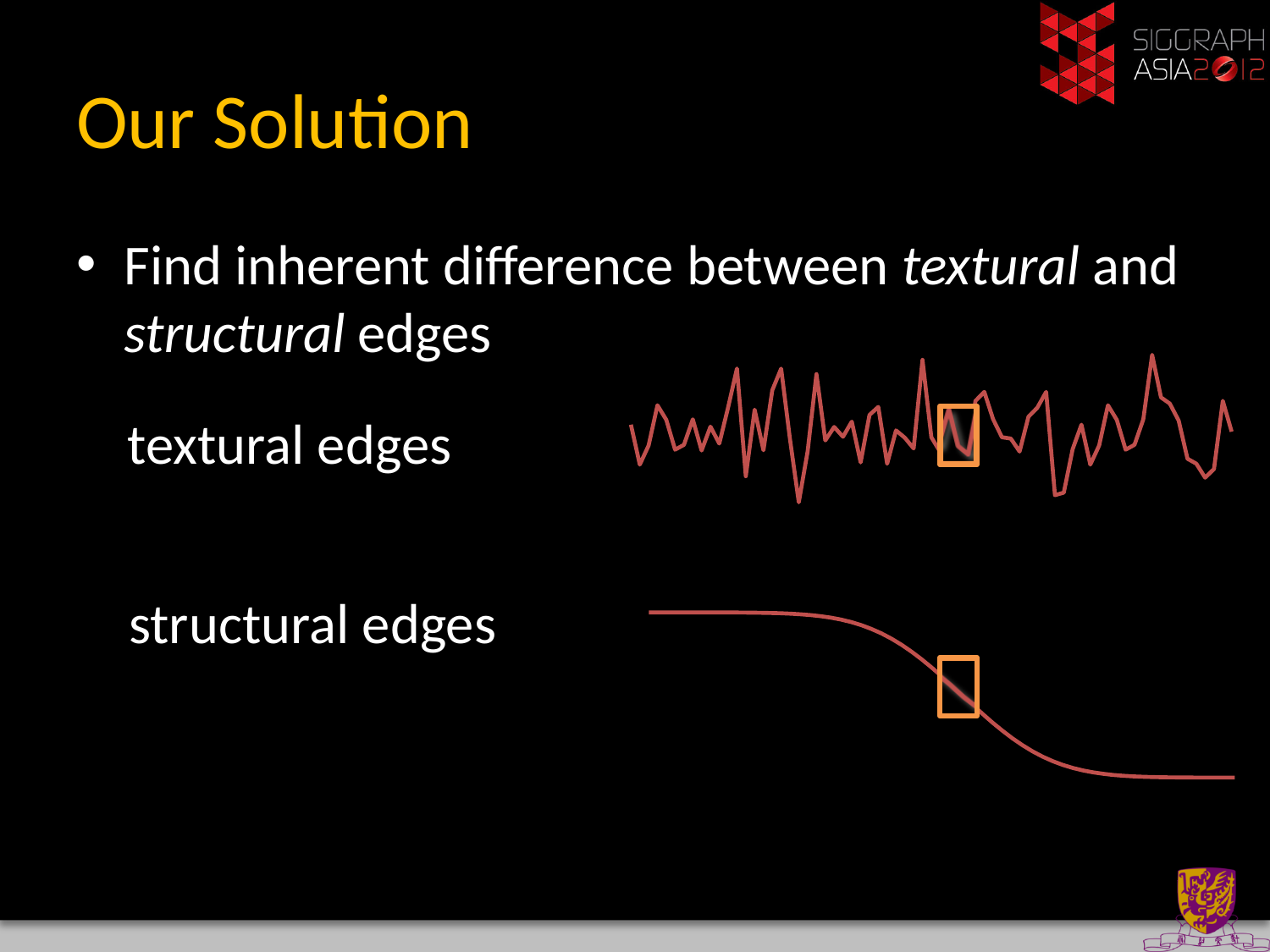
Which of the two charts on the slide shows a smooth, single step-like transition rather than rapid oscillations? structural edges How many line charts are shown on the slide? 2 What kind of chart is used to illustrate the structural edges on the slide? line chart What label is given to the upper chart with the rapidly oscillating line? textural edges What kind of chart is used to illustrate the textural edges on the slide? line chart In the structural edges chart, does the line rise or fall from left to right? fall